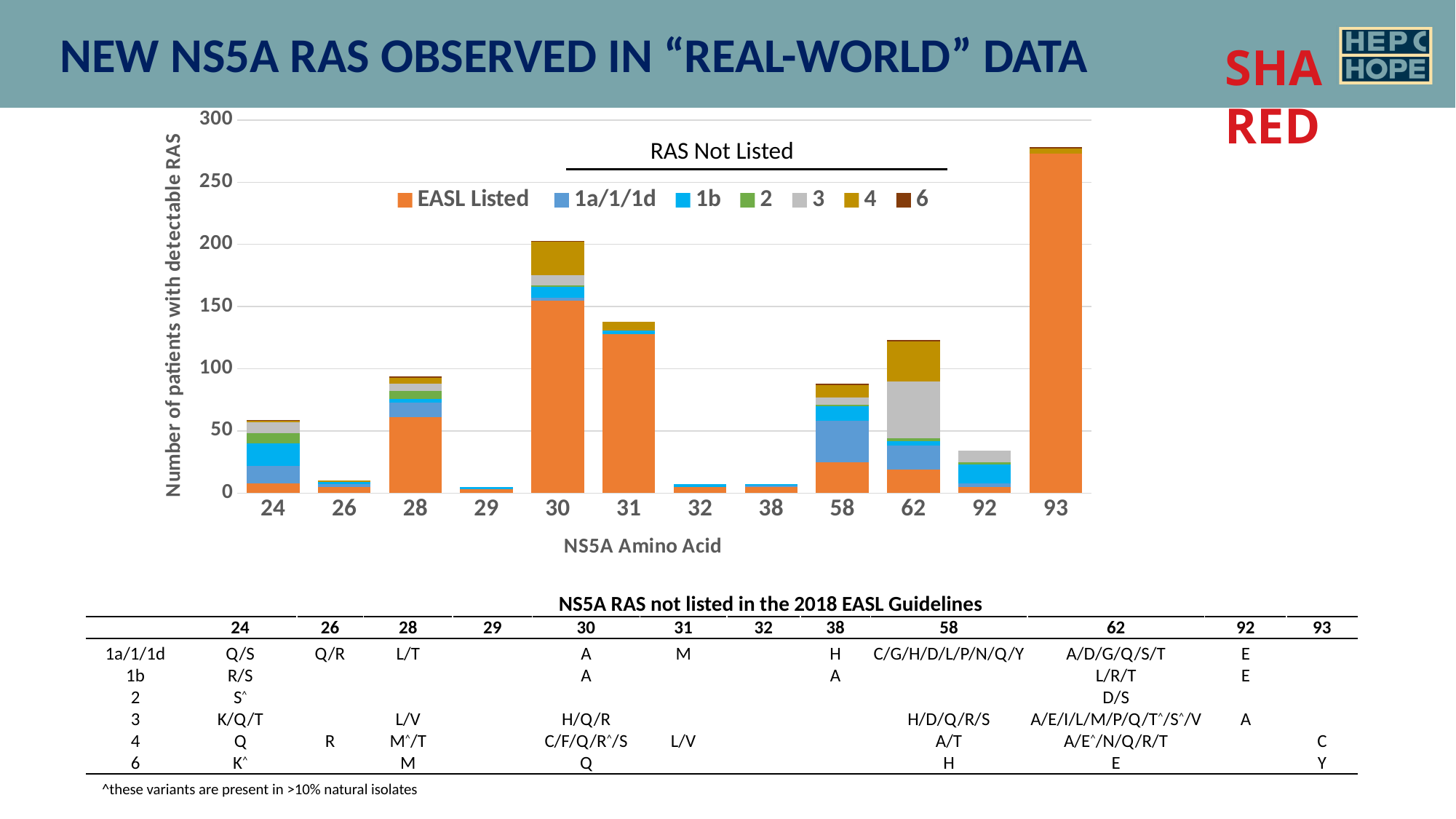
How many NS5A amino acid positions are shown on the x axis of the chart? 12 What kind of chart is shown on the slide? Stacked bar chart Is the total bar height for position 30 greater or less than 150? greater Is the total bar height for position 31 greater or less than 150? less Is the total bar height for position 62 greater or less than 100? greater How many series does the chart legend list? 7 Which NS5A amino acid position has the tallest bar? 93 What is the title of the x axis of the chart? NS5A Amino Acid Which bar is taller, position 58 or position 62? 62 Which bar is taller, position 30 or position 31? 30